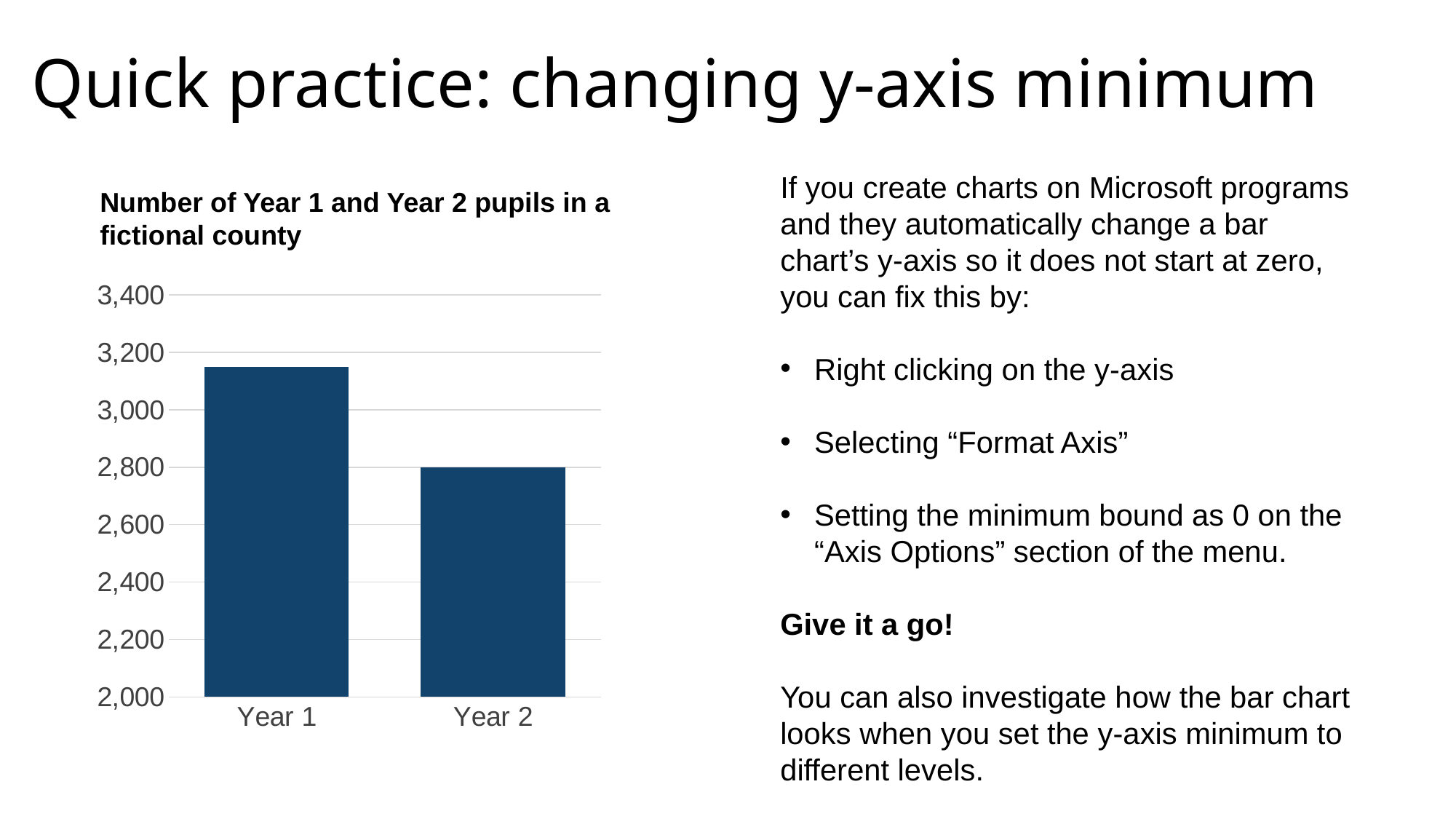
How many categories are shown on the x-axis of the chart? 2 What is the number of Year 2 pupils shown in the chart? 2,800 What kind of chart is shown on the slide? bar chart What is the title of the chart? Number of Year 1 and Year 2 pupils in a fictional county Do the values rise or fall from Year 1 to Year 2? fall Which year has the highest number of pupils in the chart? Year 1 Is the number of pupils in Year 1 greater or less than 3,000? greater What is the minimum value shown on the chart's y-axis? 2,000 Which is larger, the number of Year 1 pupils or the number of Year 2 pupils? Year 1 Is the number of pupils in Year 1 greater or less than 3,200? less Which year has the lowest number of pupils in the chart? Year 2